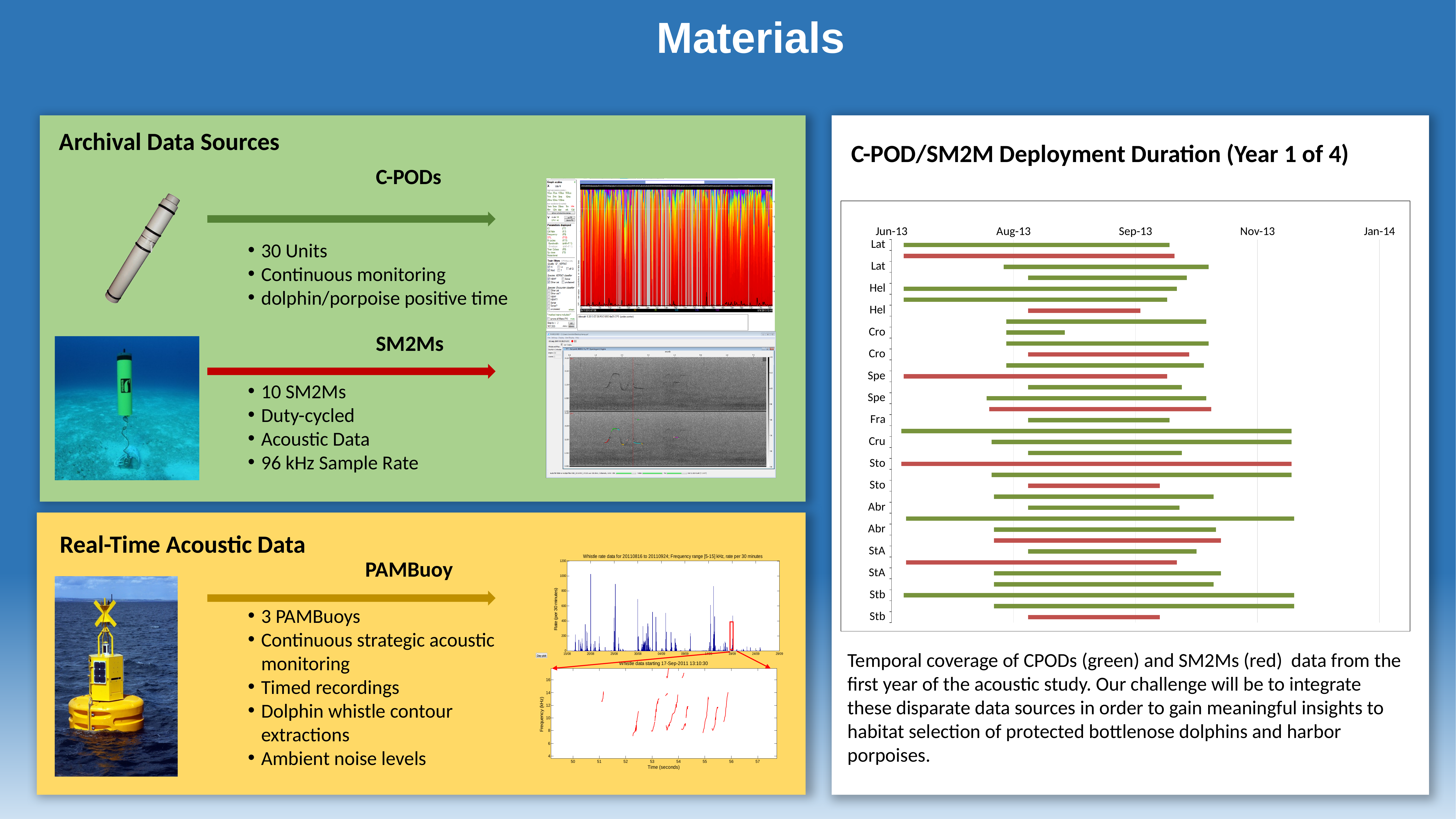
In the C-POD/SM2M Deployment Duration chart, which site label appears first at the top of the vertical axis? Lat What is the first tick label on the horizontal axis of the C-POD/SM2M Deployment Duration chart? Jun-13 In the C-POD/SM2M Deployment Duration chart, does any bar extend as far as Jan-14? No How many category labels are listed on the vertical axis of the C-POD/SM2M Deployment Duration chart? 18 How many tick labels are shown on the horizontal axis of the C-POD/SM2M Deployment Duration chart? 5 How many distinct site names appear on the vertical axis of the C-POD/SM2M Deployment Duration chart? 10 What kind of chart is the C-POD/SM2M Deployment Duration chart? bar chart What is the title of the chart on the right side of the slide? C-POD/SM2M Deployment Duration (Year 1 of 4) In the C-POD/SM2M Deployment Duration chart, which colour represents the SM2M data? red In the C-POD/SM2M Deployment Duration chart, does any bar start before Jun-13? No What is the last tick label on the horizontal axis of the C-POD/SM2M Deployment Duration chart? Jan-14